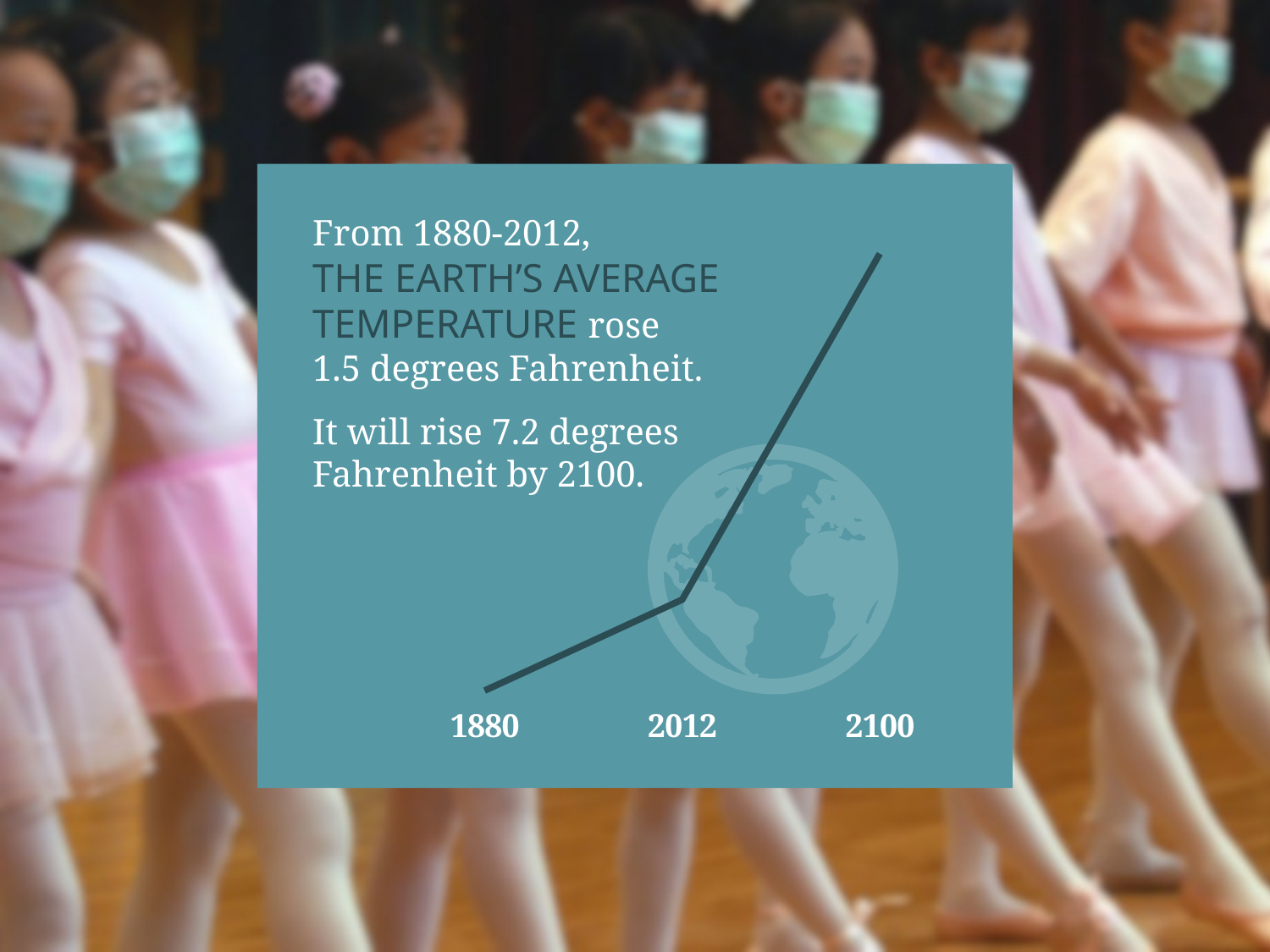
What is the first year labelled on the x axis of the chart? 1880 Which segment of the line is steeper: 1880 to 2012, or 2012 to 2100? 2012 to 2100 Is the line higher at 2012 or at 2100? 2100 How many years are labelled on the x axis of the chart? 3 Does the line in the chart rise or fall from 1880 to 2100? rise What kind of chart is shown on the slide? line chart What are the three labels on the x axis of the chart, from left to right? 1880, 2012, 2100 Is the line higher at 1880 or at 2012? 2012 At which labelled year is the line at its lowest point? 1880 At which labelled year does the line reach its highest point? 2100